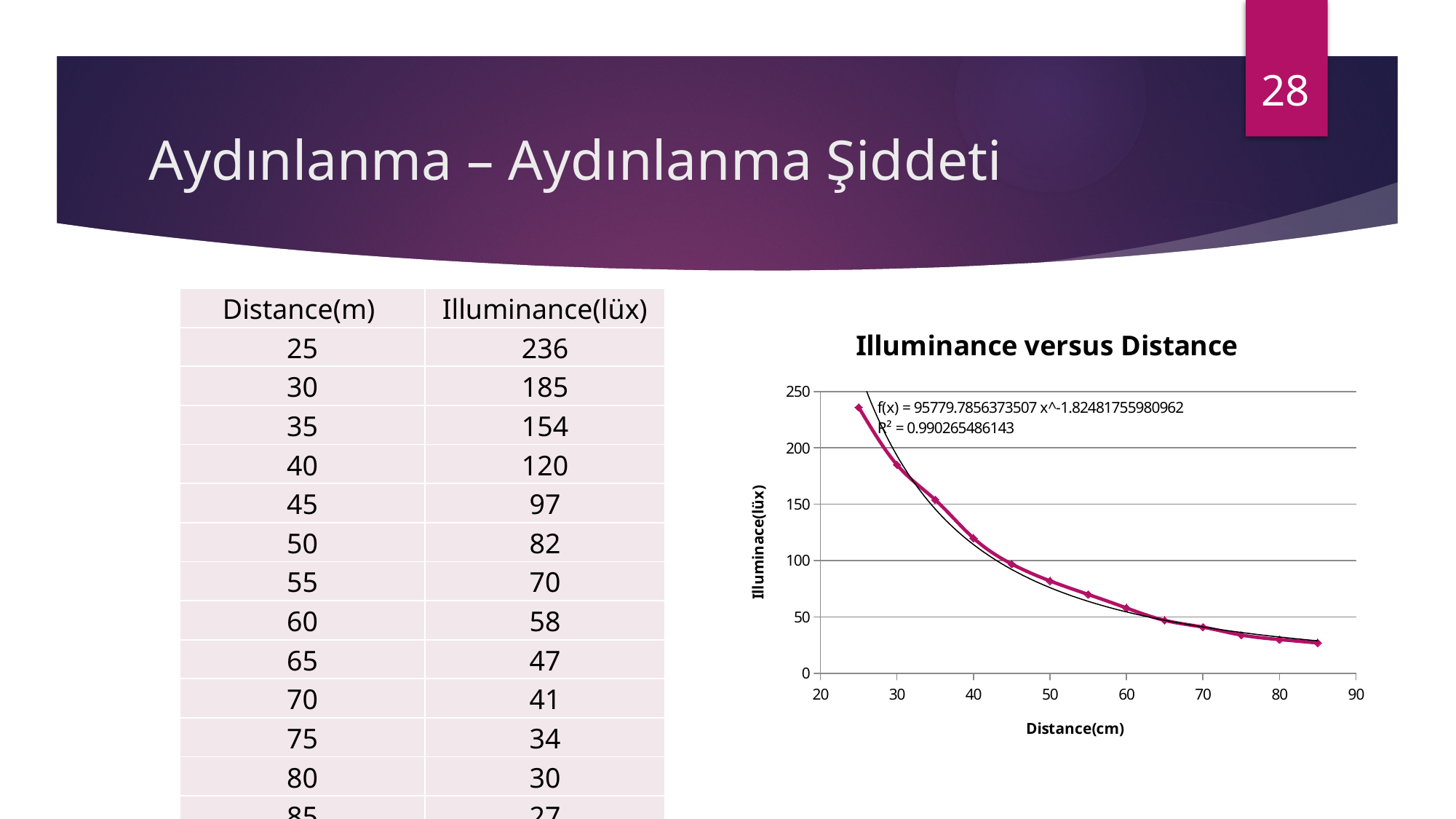
At which distance is the illuminance highest? 25 Which distance has the larger illuminance, 45 or 55? 45 How many data points are plotted on the chart? 13 At which distance is the illuminance lowest? 85 Do the illuminance values rise or fall as distance increases along the x axis? fall What is the illuminance at a distance of 50? 82 What kind of chart is shown on the slide? line chart What is the difference in illuminance between distances 25 and 30? 51 Is the illuminance at a distance of 40 greater or less than 100? greater What R² value is printed on the chart? 0.990265486143 Is the illuminance at a distance of 75 greater or less than 50? less What is the title of the chart? Illuminance versus Distance